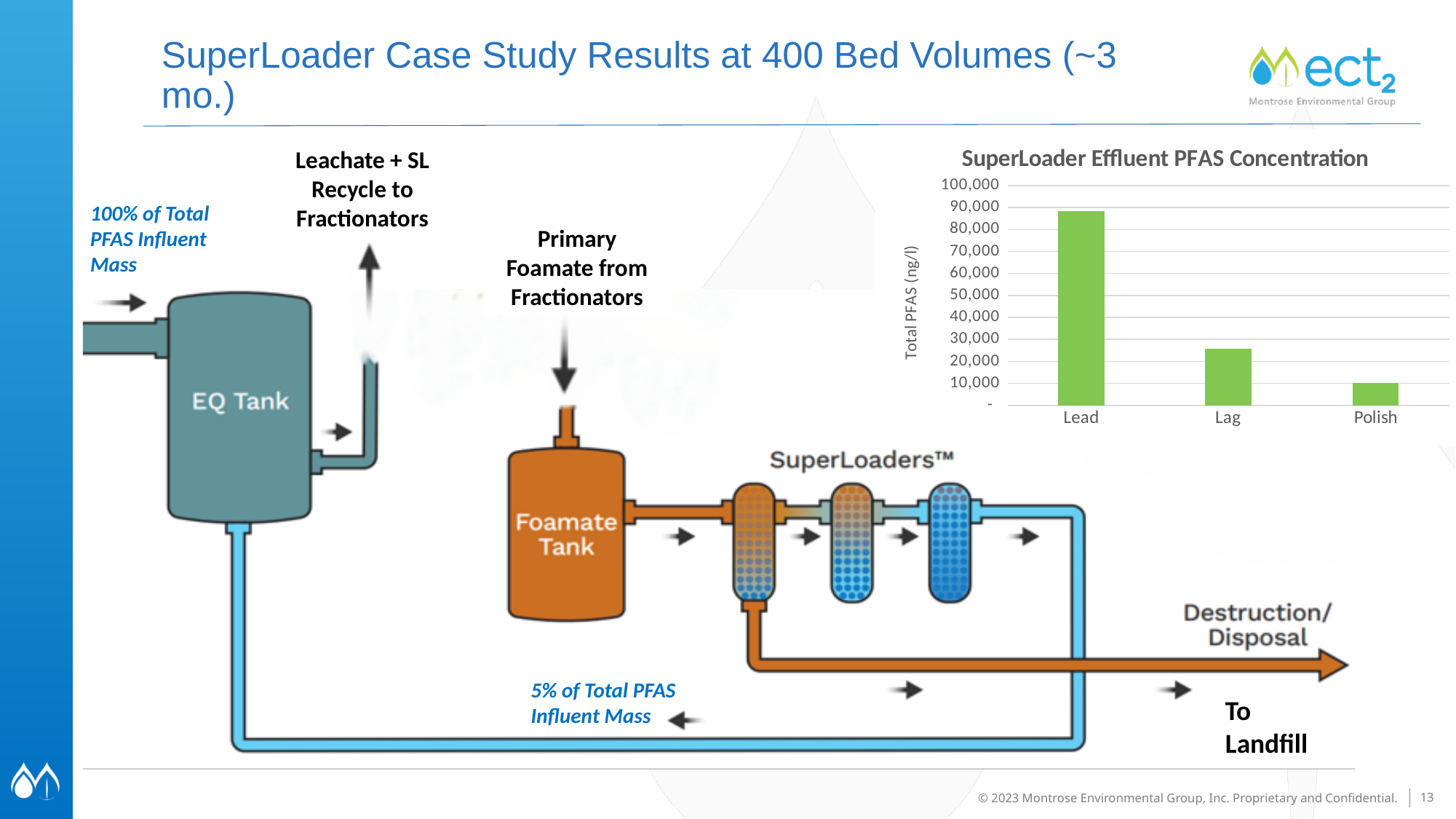
How many categories are plotted in the SuperLoader Effluent PFAS Concentration chart? 3 Which category has the lowest effluent PFAS concentration in the chart? Polish Is the value for Lead greater or less than 80,000? greater Which category has the highest effluent PFAS concentration in the chart? Lead Is the value for Lag greater or less than 20,000? greater Which has a higher effluent PFAS concentration, Lead or Lag? Lead Is the value for Lead greater or less than 90,000? less What is the title of the chart on the slide? SuperLoader Effluent PFAS Concentration Do the values rise or fall moving from Lead to Polish along the x axis? fall What kind of chart is shown on the slide? bar chart